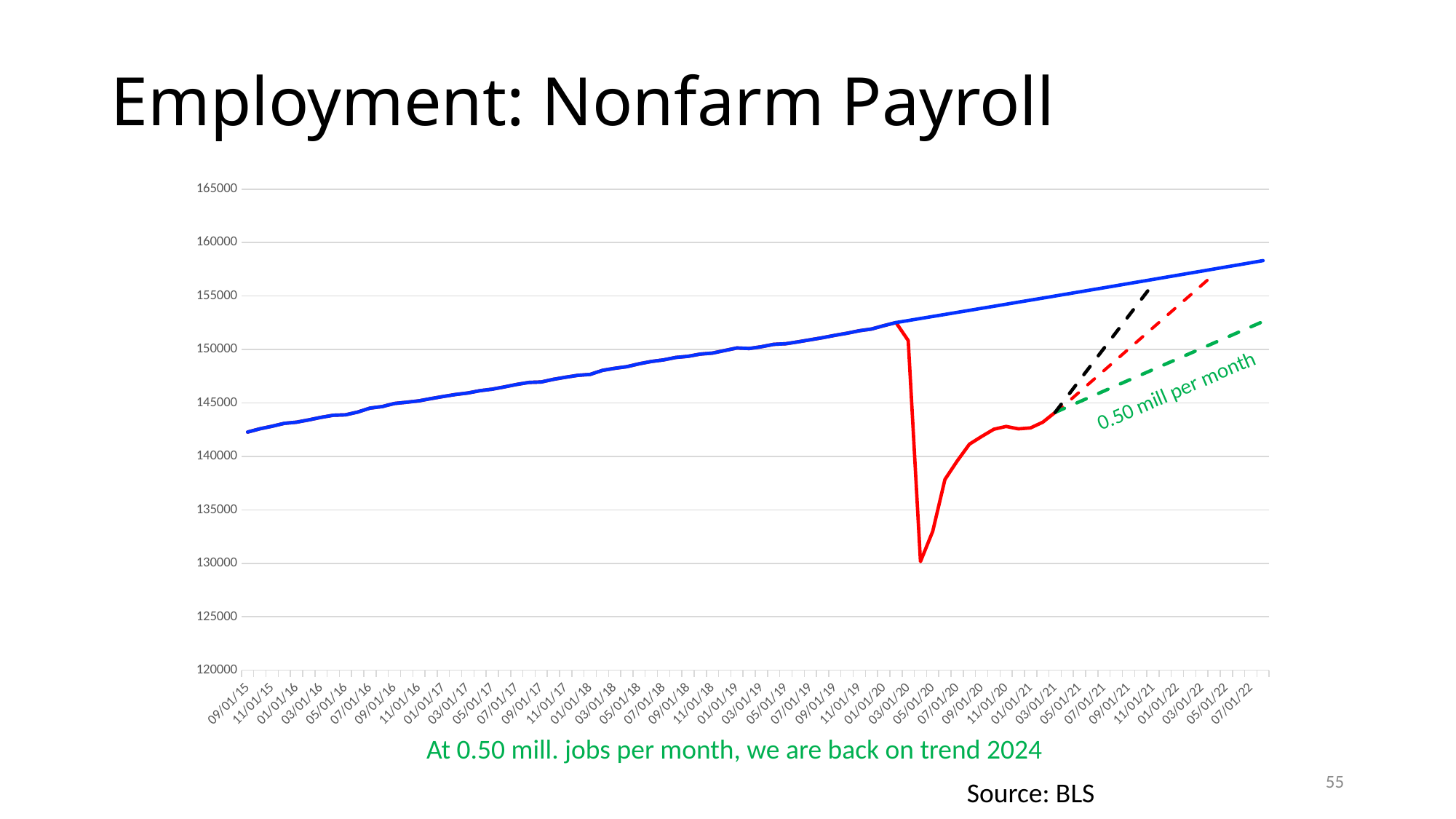
Which line is higher at 01/01/21, the blue line or the red line? blue line How many dashed projection lines extend from the red line? 3 Is the value of the blue line at 07/01/22 greater or less than 155000? greater What kind of chart is shown on the slide? line chart Does the blue line rise or fall from 09/01/15 to 07/01/22? rise What is the source cited for the chart? BLS What rate of job growth is labelled next to the green dashed line? 0.50 mill per month What is the highest value shown on the vertical axis? 165000 Is the lowest point of the red line greater or less than 135000? less Is the value of the red line at 01/01/21 greater or less than 145000? less What is the title of the slide's chart? Employment: Nonfarm Payroll